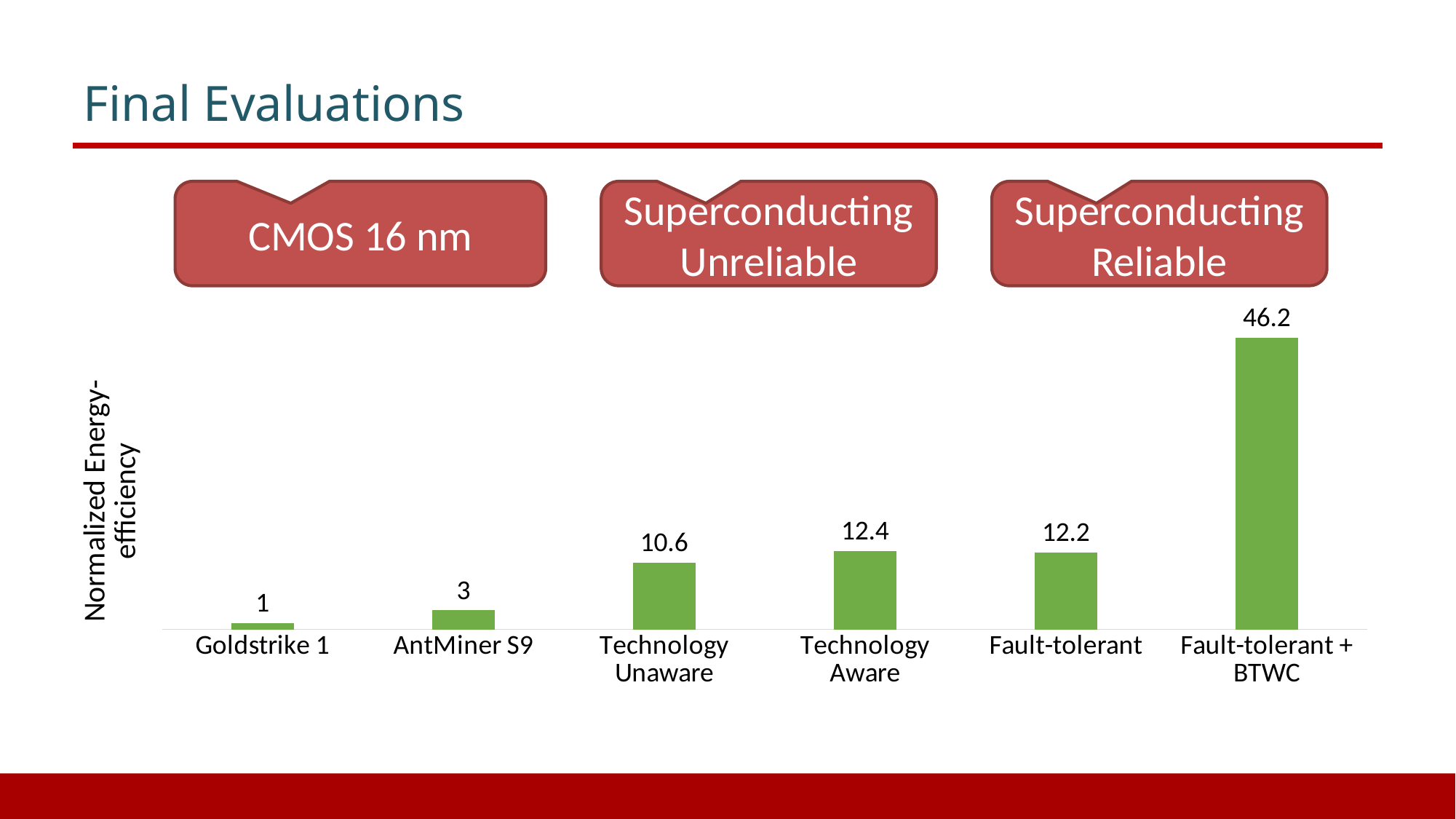
What is the normalized energy-efficiency value for AntMiner S9? 3 What is the difference between the values for Fault-tolerant + BTWC and Fault-tolerant? 34 Which has a larger value, Technology Aware or Fault-tolerant? Technology Aware Which category has the lowest normalized energy-efficiency? Goldstrike 1 Which group label is shown above the Goldstrike 1 and AntMiner S9 bars? CMOS 16 nm What is the label of the vertical axis of the chart? Normalized Energy-efficiency How many categories are shown on the x axis of the chart? 6 What is the normalized energy-efficiency value for Fault-tolerant + BTWC? 46.2 What is the normalized energy-efficiency value for Technology Unaware? 10.6 Which category has the highest normalized energy-efficiency? Fault-tolerant + BTWC What is the difference between the values for Technology Aware and Technology Unaware? 1.8 What kind of chart is shown on the slide? Bar chart